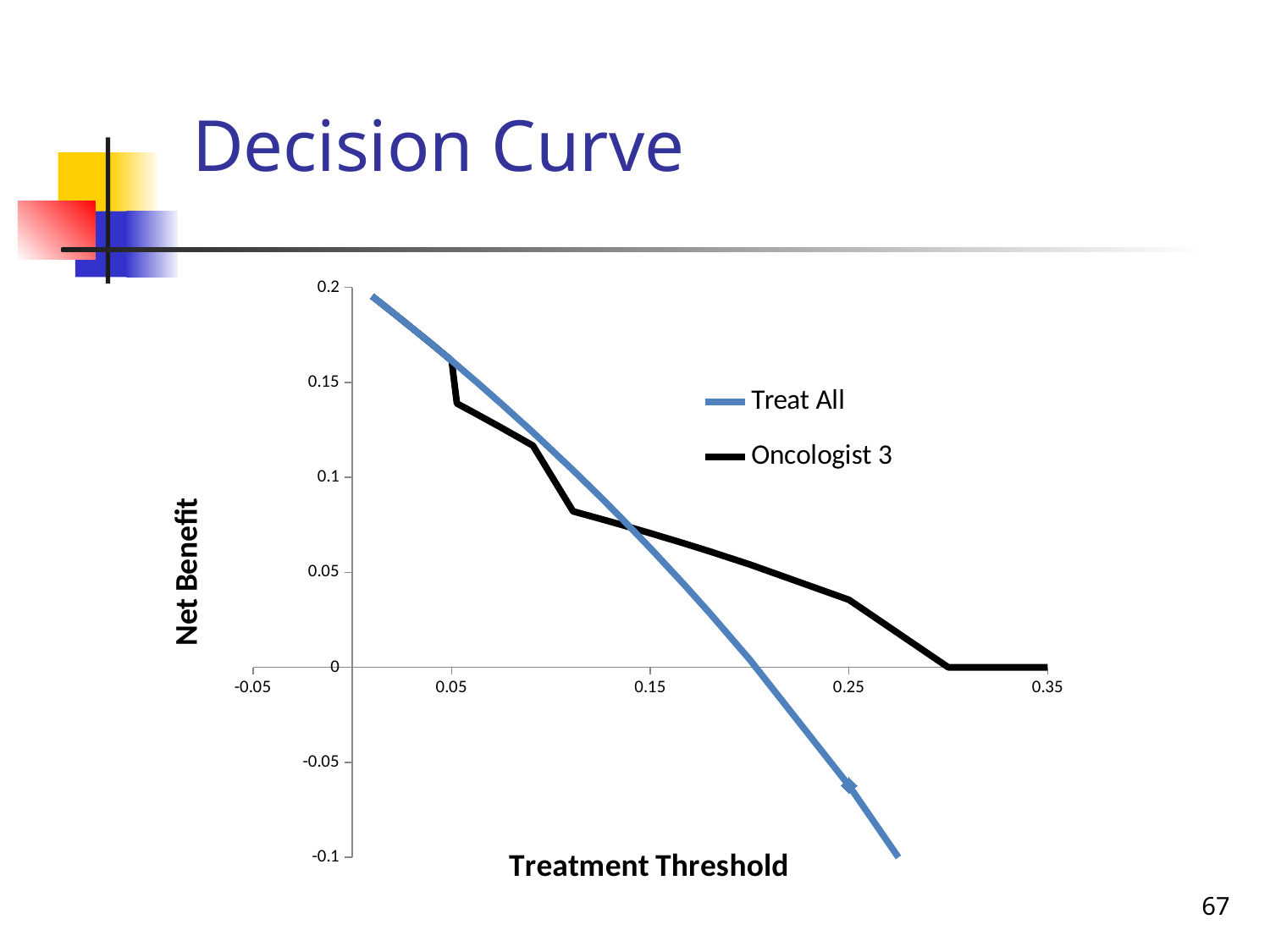
Does the Oncologist 3 line rise or fall as Treatment Threshold increases? Fall Does the Treat All line rise or fall as Treatment Threshold increases? Fall What is the title of the chart? Decision Curve At a Treatment Threshold of 0.25, which series has the higher Net Benefit, Treat All or Oncologist 3? Oncologist 3 At a Treatment Threshold of 0.3, which series has the higher Net Benefit, Treat All or Oncologist 3? Oncologist 3 What kind of chart is shown on the slide? Line chart What is the label of the vertical axis? Net Benefit Is the Net Benefit for Oncologist 3 at a Treatment Threshold of 0.15 greater or less than 0.05? greater Is the Net Benefit for Oncologist 3 at a Treatment Threshold of 0.25 greater or less than 0? greater How many series does the legend list? 2 Is the Net Benefit for Treat All at a Treatment Threshold of 0.25 greater or less than 0? less